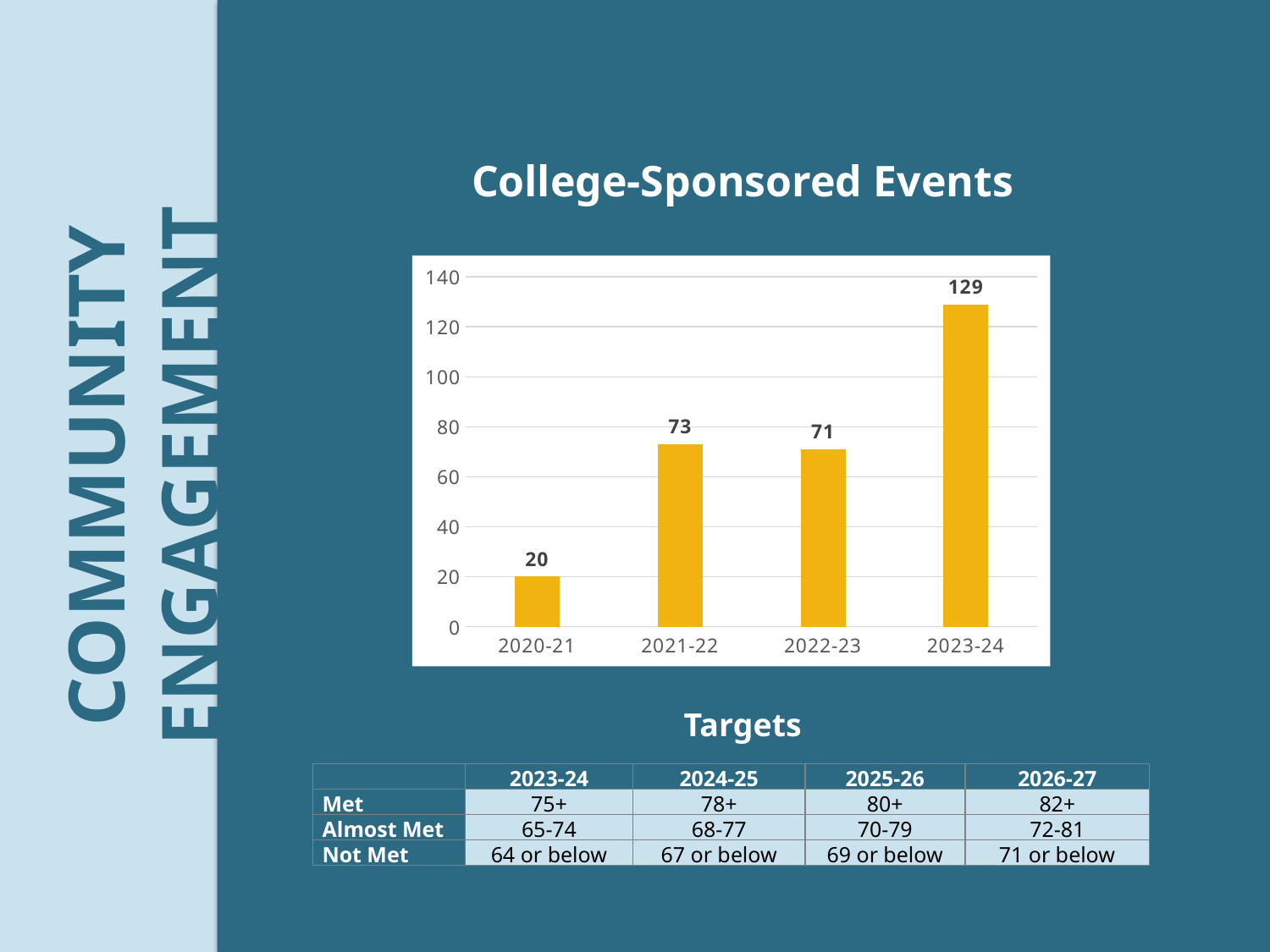
What is the value for 2020-21 in the College-Sponsored Events chart? 20 How many years are shown in the College-Sponsored Events chart? 4 Which year has the highest number of College-Sponsored Events? 2023-24 What is the difference between the 2021-22 and 2020-21 values in the College-Sponsored Events chart? 53 What is the value for 2021-22 in the College-Sponsored Events chart? 73 Which year has the lowest number of College-Sponsored Events? 2020-21 What is the value for 2022-23 in the College-Sponsored Events chart? 71 Which is larger in the College-Sponsored Events chart, the value for 2020-21 or the value for 2022-23? 2022-23 What is the title of the chart on the slide? College-Sponsored Events What is the difference between the 2023-24 and 2022-23 values in the College-Sponsored Events chart? 58 What kind of chart is the College-Sponsored Events chart? bar chart What is the value for 2023-24 in the College-Sponsored Events chart? 129